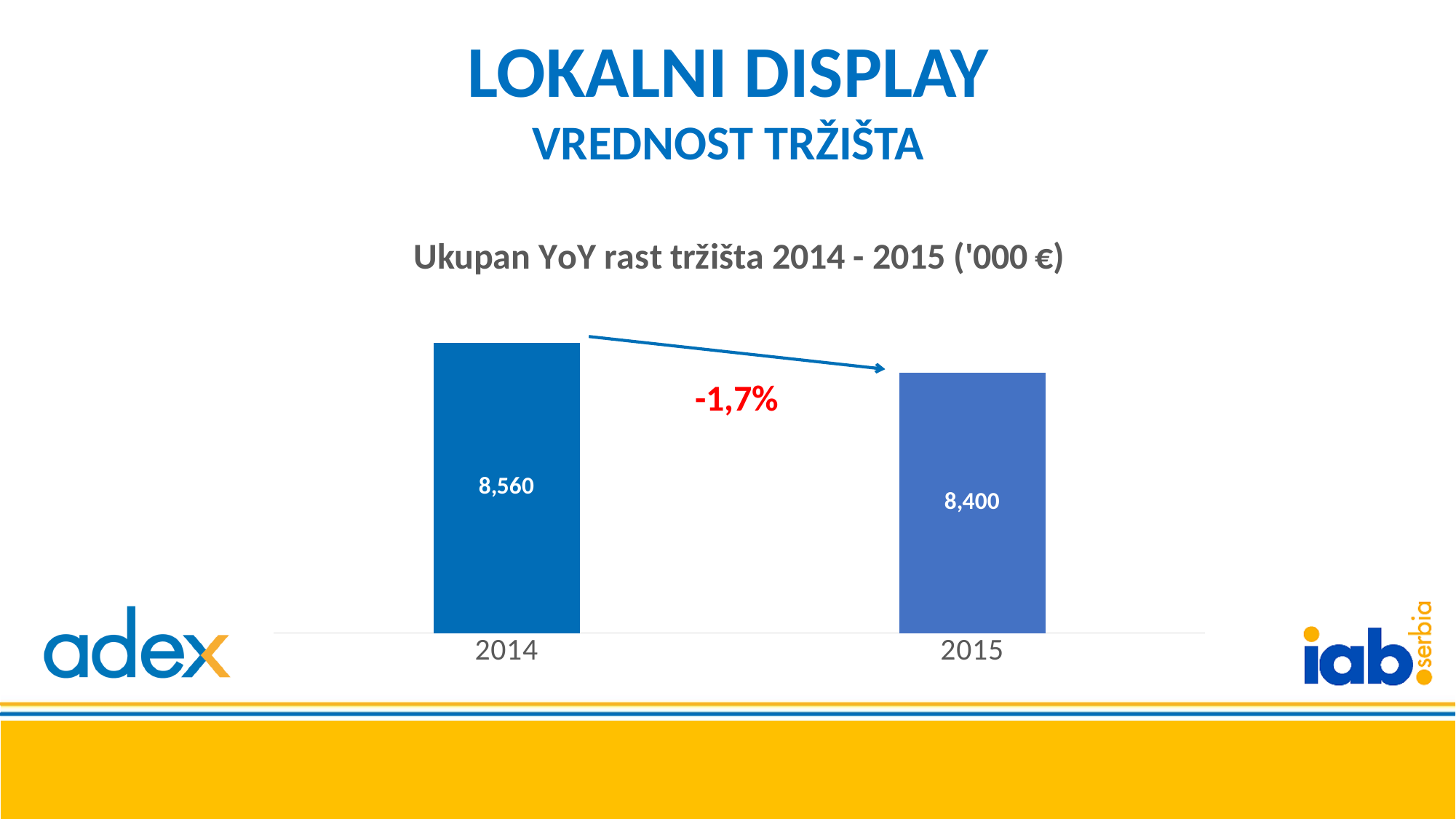
What is the difference between the 2014 and 2015 values? 160 Which year has the lower value? 2015 What is the title of the chart? Ukupan YoY rast tržišta 2014 - 2015 ('000 €) Do the values rise or fall from 2014 to 2015? fall How many years are shown on the chart? 2 What percentage change is annotated between the two bars? -1,7% What is the value for 2014? 8,560 What is the value for 2015? 8,400 Which year has the higher value? 2014 What kind of chart is shown on the slide? bar chart Is the value for 2014 larger or smaller than the value for 2015? larger